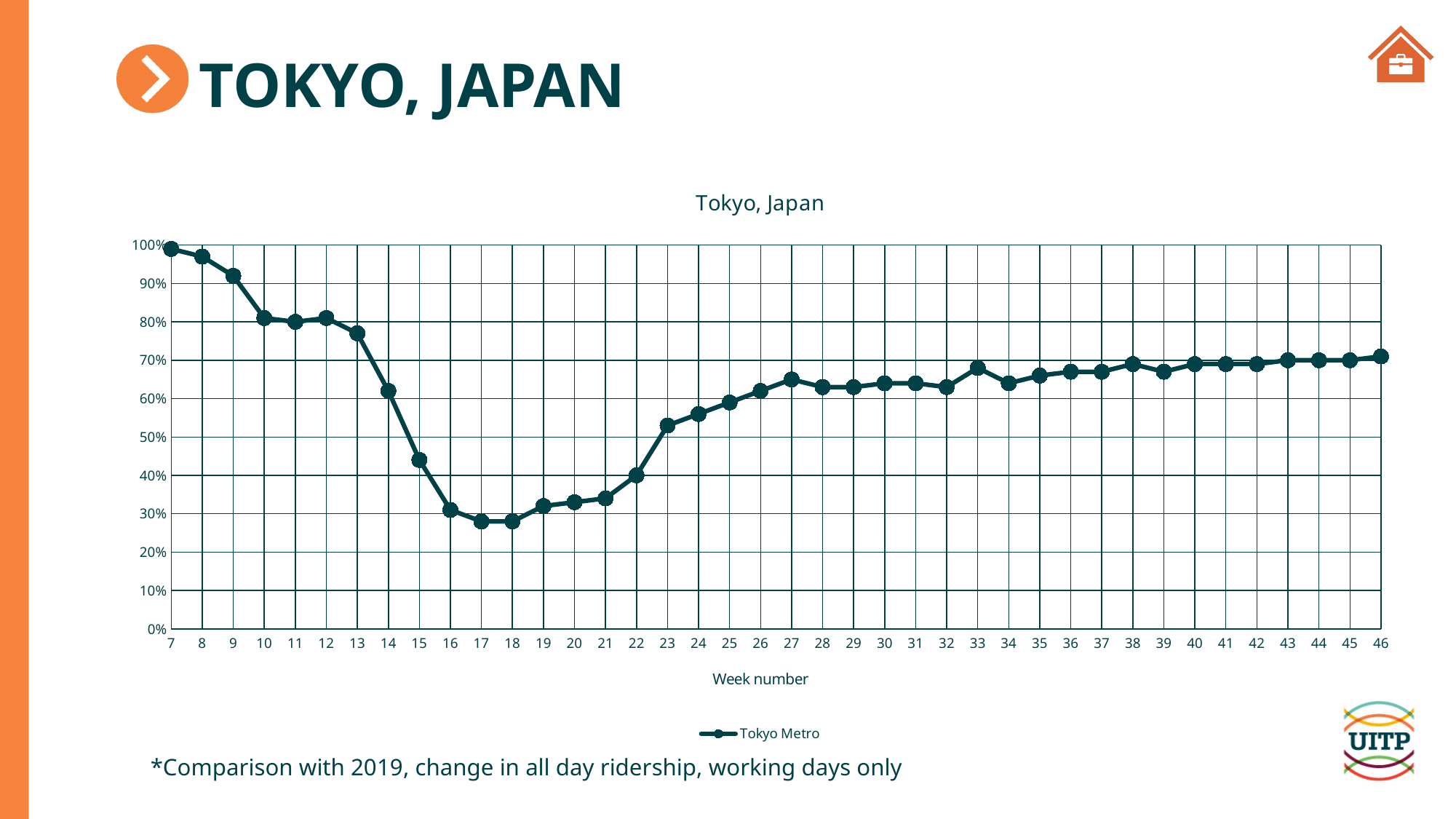
Does the value rise or fall from week 7 to week 17? fall Is the value for week 13 greater or less than 80%? less What is the title of the x axis? Week number Is the value for week 15 greater or less than 40%? greater What kind of chart is shown on the slide? line chart Which is larger, the value for week 14 or the value for week 24? week 14 Is the value for week 23 greater or less than 50%? greater What is the name of the series shown in the legend? Tokyo Metro How many weeks are plotted on the x axis? 40 How many series does the legend list? 1 Which week has the highest value for Tokyo Metro? 7